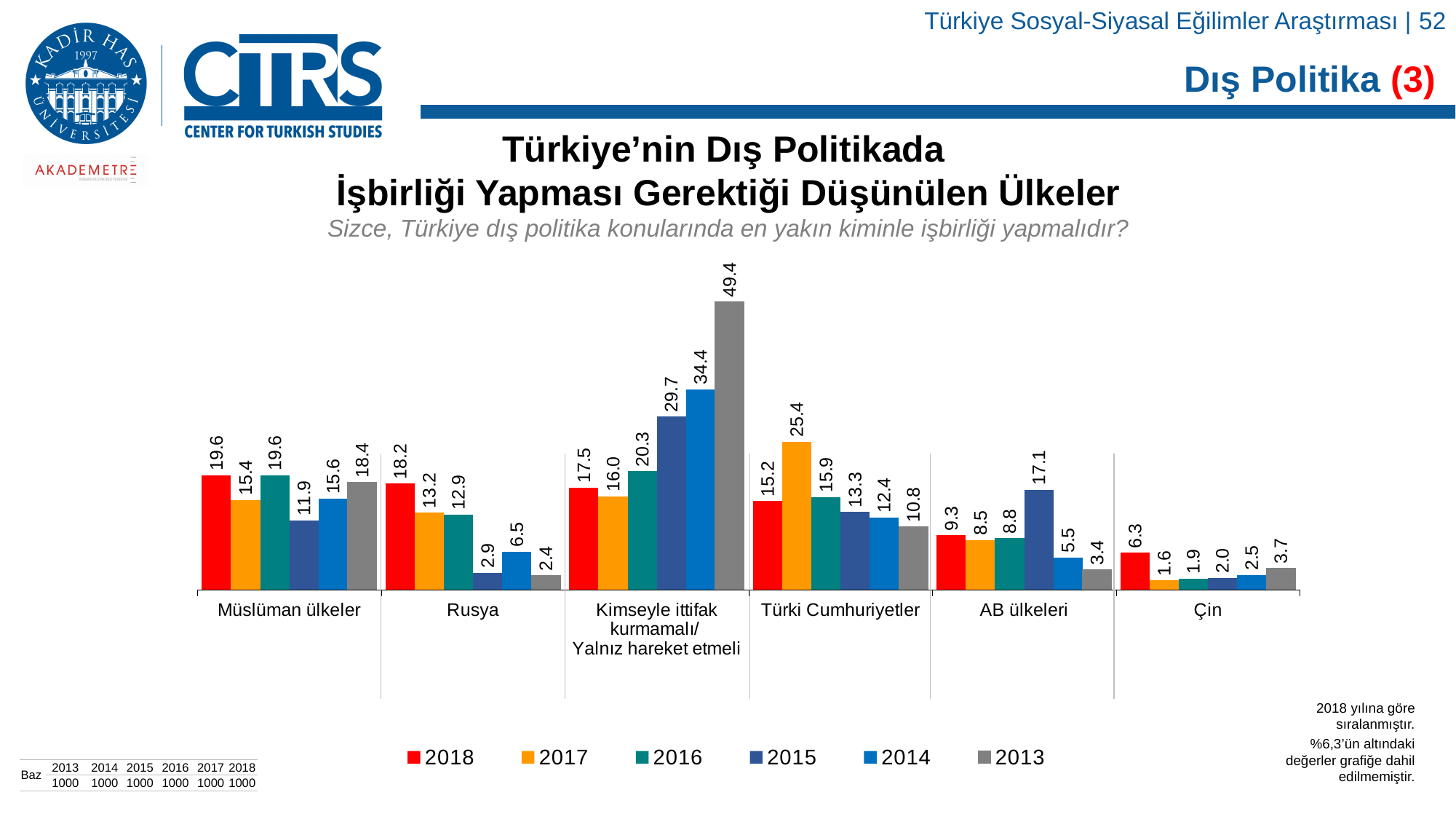
Which category has the lowest value in 2017? Çin What is the value for AB ülkeleri in 2015? 17.1 How many categories are shown on the x axis? 6 What is the difference between the 2013 and 2018 values for Kimseyle ittifak kurmamalı/ Yalnız hareket etmeli? 31.9 Which year does the red series represent in the legend? 2018 What kind of chart is shown on the slide? Bar chart What is the difference between the 2018 and 2017 values for Müslüman ülkeler? 4.2 What is the value for Çin in 2013? 3.7 What is the value for Rusya in 2018? 18.2 Which is larger for Türki Cumhuriyetler: the 2017 value or the 2018 value? 2017 How many series does the legend list? 6 Which category has the highest value in 2013? Kimseyle ittifak kurmamalı/ Yalnız hareket etmeli